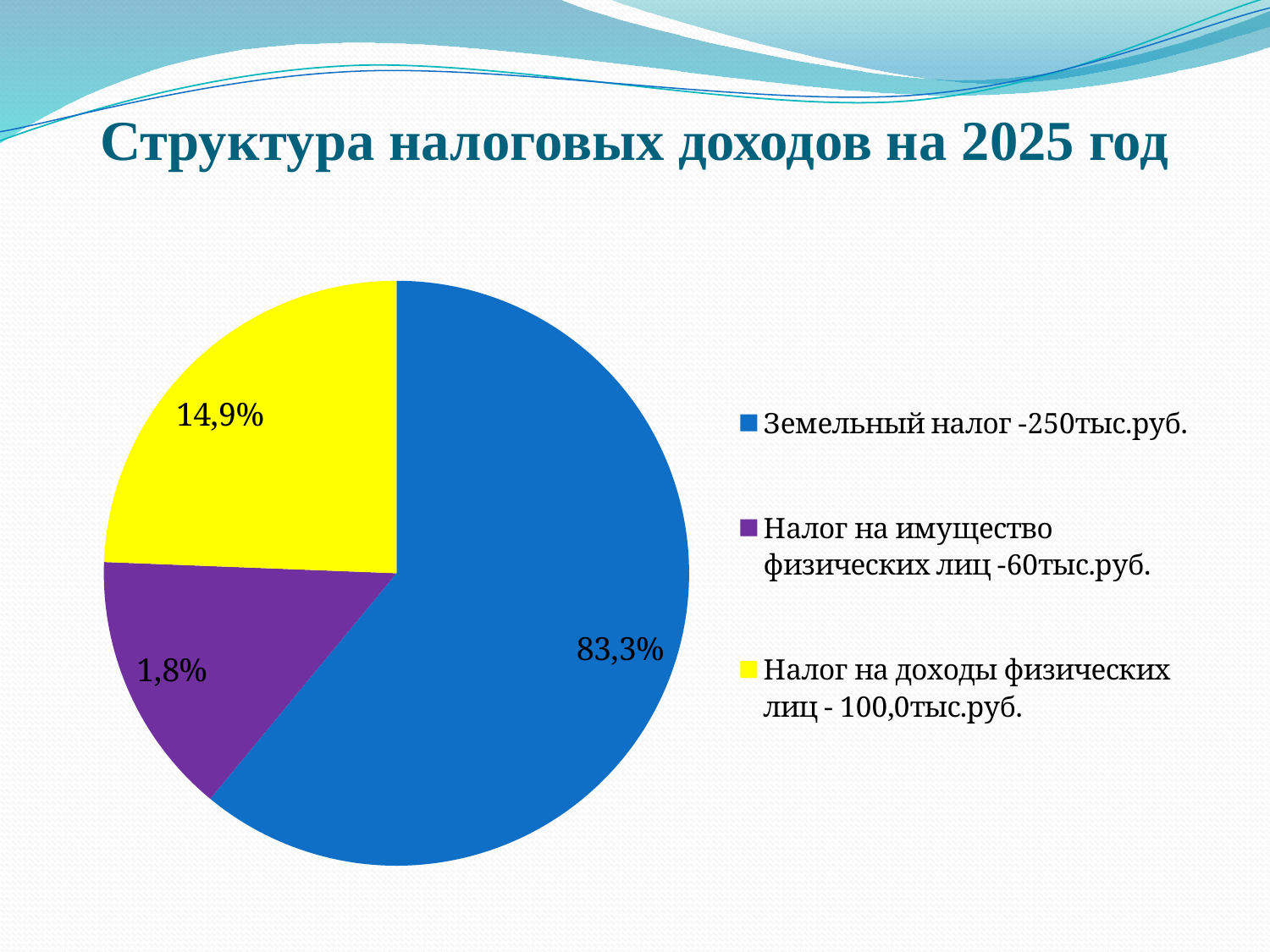
What is the title of the chart on the slide? Структура налоговых доходов на 2025 год Which category has the largest share of the pie? Земельный налог What percentage is shown for Земельный налог? 83,3% How many entries does the legend list? 3 What colour is the slice for Налог на доходы физических лиц? Yellow What percentage is shown for Налог на доходы физических лиц? 14,9% What percentage is shown for Налог на имущество физических лиц? 1,8% Which category has the smallest share of the pie? Налог на имущество физических лиц How many slices does the pie chart have? 3 What type of chart is shown on the slide? Pie chart What is the difference in percentage points between the Земельный налог share and the Налог на доходы физических лиц share? 68,4 Which is larger: the share for Земельный налог or the share for Налог на доходы физических лиц? Земельный налог